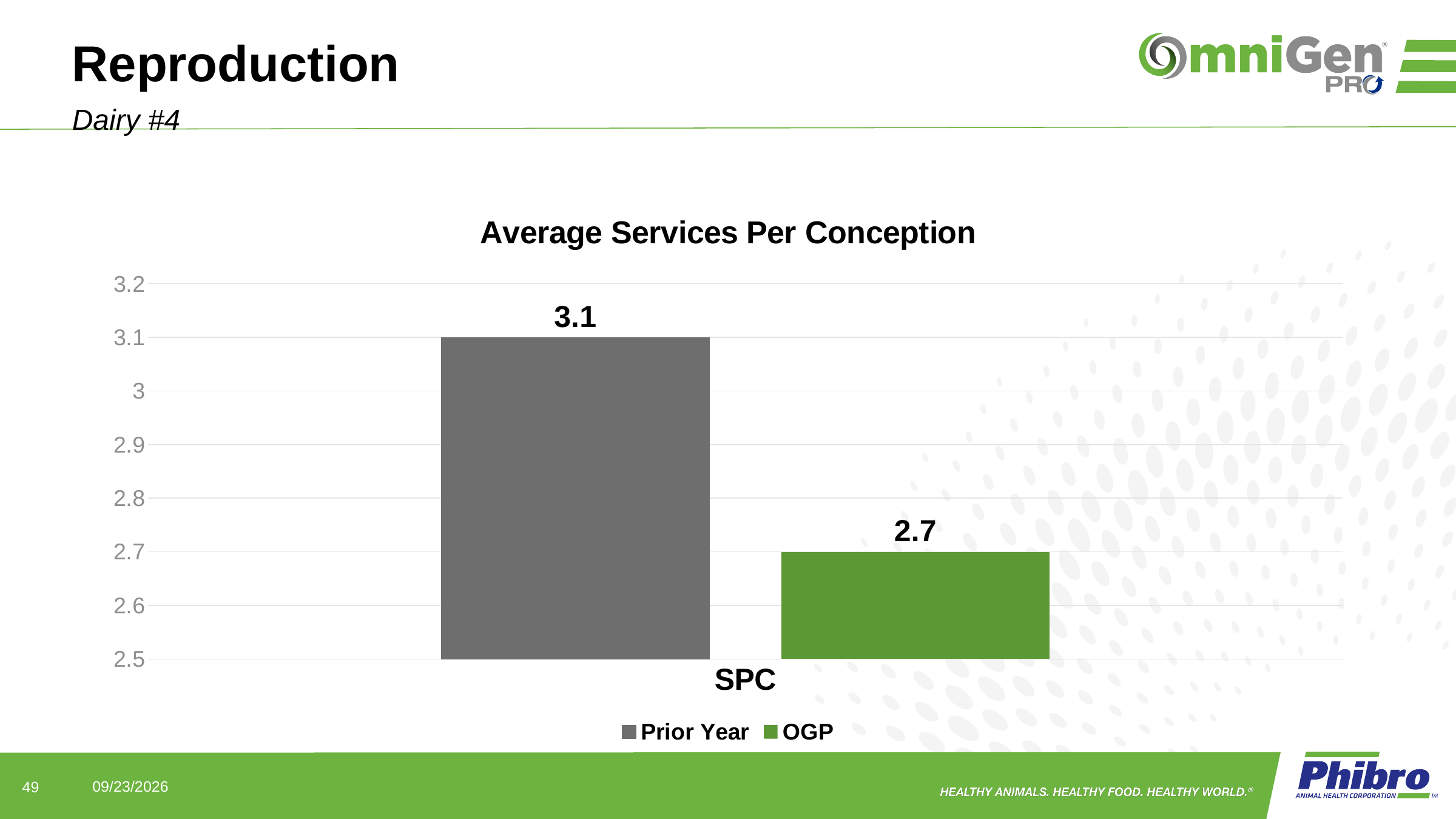
What is the difference between the Prior Year and OGP values? 0.4 What is the value for OGP in the Average Services Per Conception chart? 2.7 Is the value for OGP greater or less than 3? less What is the value for Prior Year in the Average Services Per Conception chart? 3.1 Which series has the lowest value in the chart? OGP How many categories are shown on the x axis? 1 What is the category label on the x axis of the chart? SPC How many series does the legend list? 2 Is the value for Prior Year greater or less than 2.9? greater What kind of chart is shown on the slide? bar chart What is the title of the chart? Average Services Per Conception Which series has the higher value, Prior Year or OGP? Prior Year